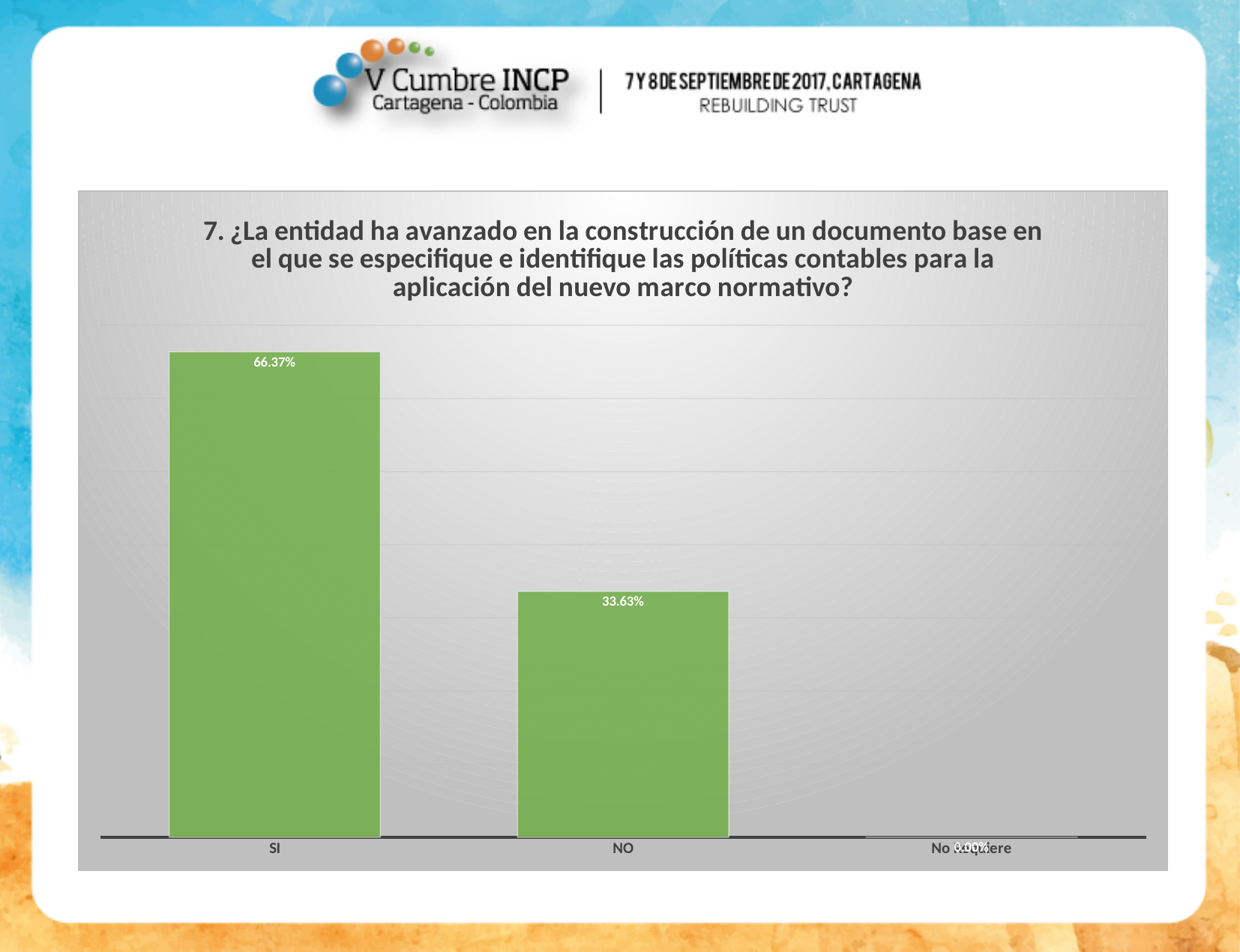
What kind of chart is shown on the slide? Bar chart What is the value shown for the third category, No requiere? 0.00% What percentage of respondents answered NO? 33.63% Which is larger, the value for SI or the value for NO? SI What question number is shown in the chart title? 7 How many response categories are shown on the x axis? 3 What colour are the bars in the chart? Green What percentage of respondents answered SI? 66.37% Which response category has the lowest value? No requiere Do the values rise or fall moving from left to right along the x axis? Fall Which response category has the highest value? SI What is the difference between the SI and NO percentages? 32.74%